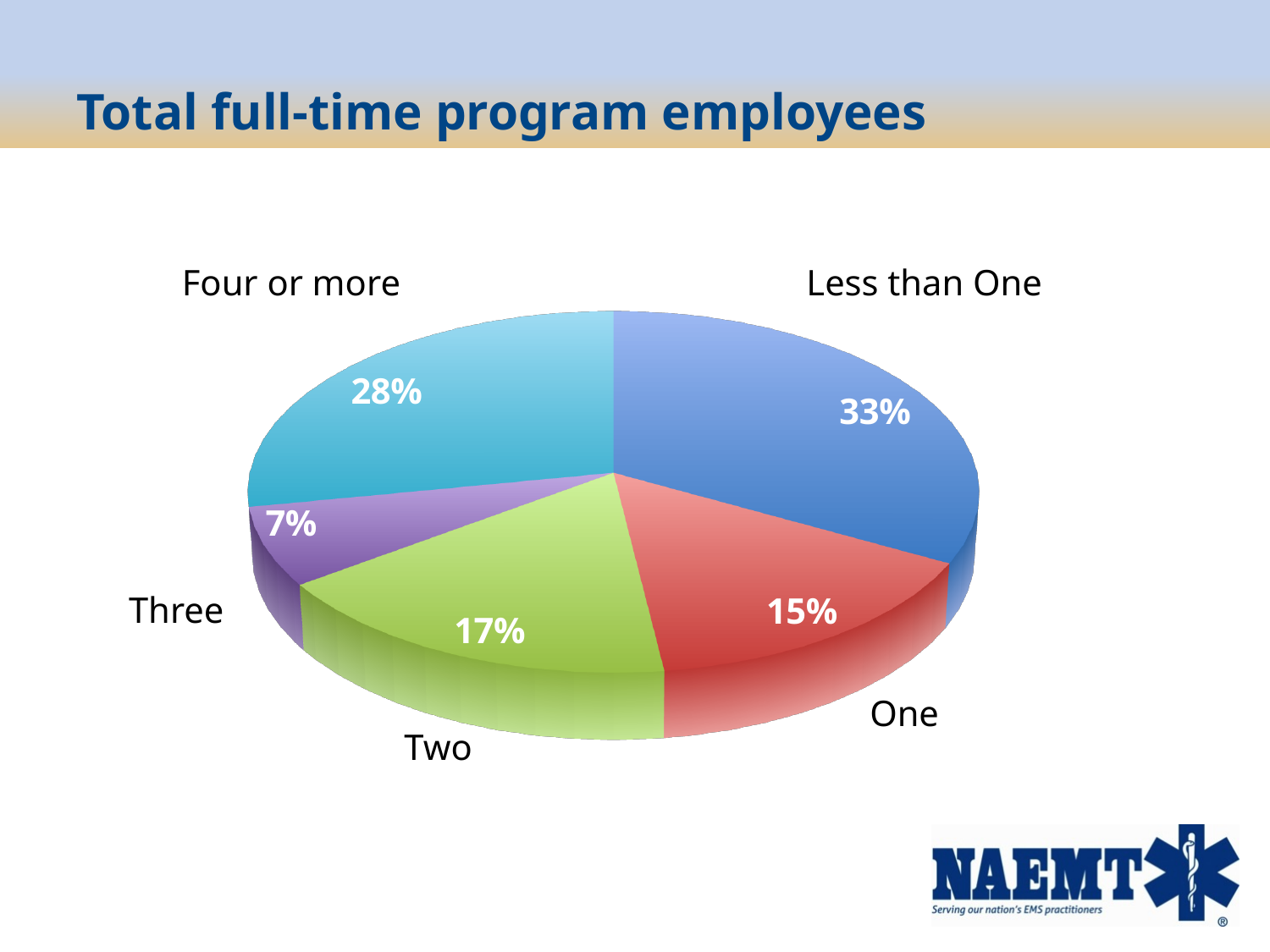
What share of the pie is labelled "Three"? 7% What kind of chart is shown on the slide? Pie chart Which category has the largest slice of the pie? Less than One What share of the pie is labelled "Less than One"? 33% What is the title of the chart on the slide? Total full-time program employees Which slice is larger, "Two" or "One"? Two Which category has the smallest slice of the pie? Three What share of the pie is labelled "Four or more"? 28% What share of the pie is labelled "Two"? 17% How many categories are shown in the pie chart? 5 What share of the pie is labelled "One"? 15% What is the difference in percentage points between the "Less than One" slice and the "Four or more" slice? 5